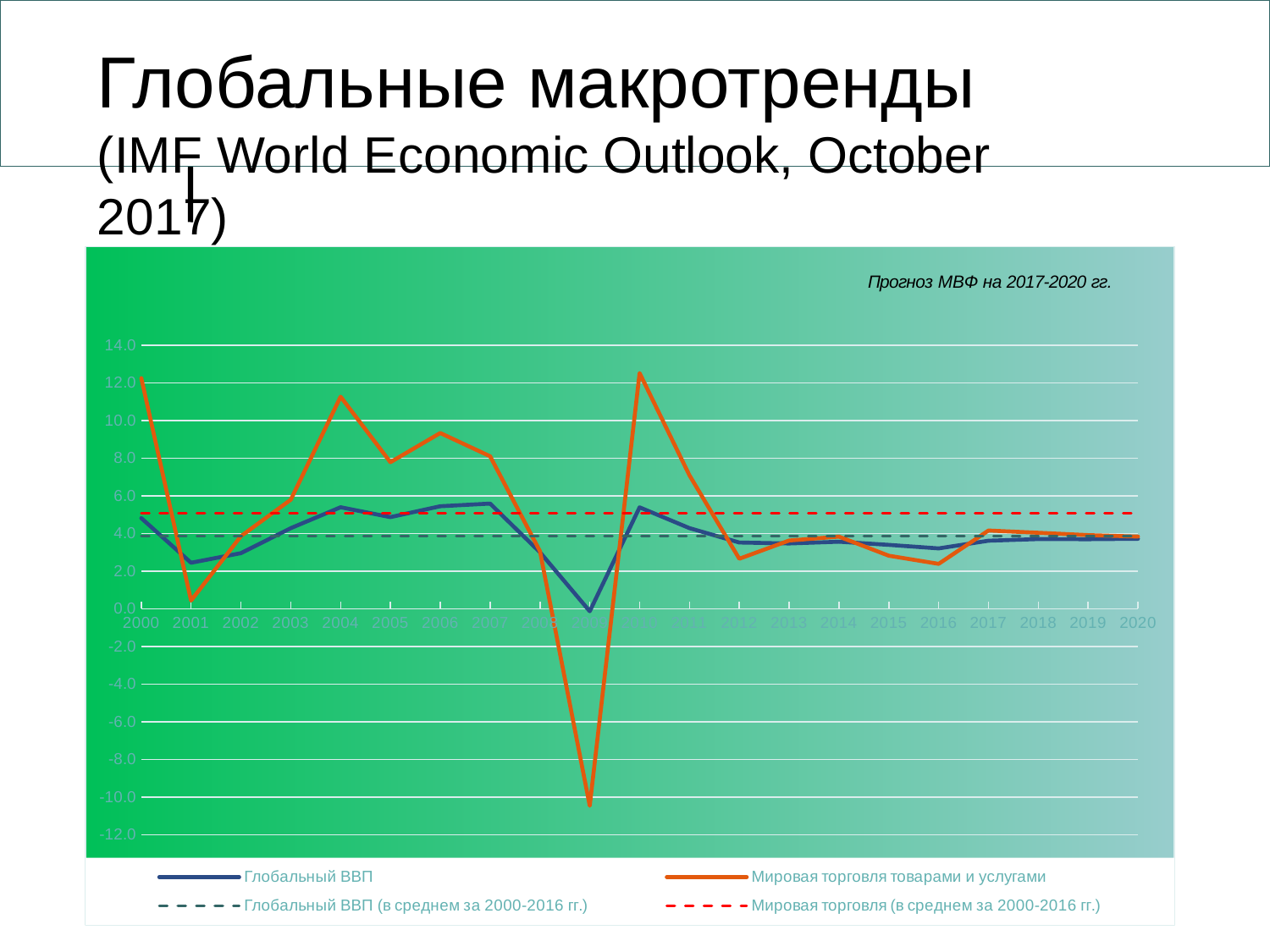
In which year does the series 'Глобальный ВВП' reach its lowest value? 2009 What kind of chart is shown on the slide? Line chart Is the value of 'Мировая торговля товарами и услугами' in 2004 greater or less than 10.0? greater Is the value of 'Мировая торговля товарами и услугами' in 2009 greater or less than -8.0? less In 2009, which series has the larger value: 'Глобальный ВВП' or 'Мировая торговля товарами и услугами'? Глобальный ВВП In which year does the series 'Мировая торговля товарами и услугами' reach its lowest value? 2009 Is the value of 'Мировая торговля товарами и услугами' in 2001 greater or less than 2.0? less Does the series 'Мировая торговля товарами и услугами' rise or fall from 2004 to 2005? Fall How many series does the chart legend list? 4 What note is printed in the top right corner of the chart area? Прогноз МВФ на 2017-2020 гг. How many years are shown along the x axis of the chart? 21